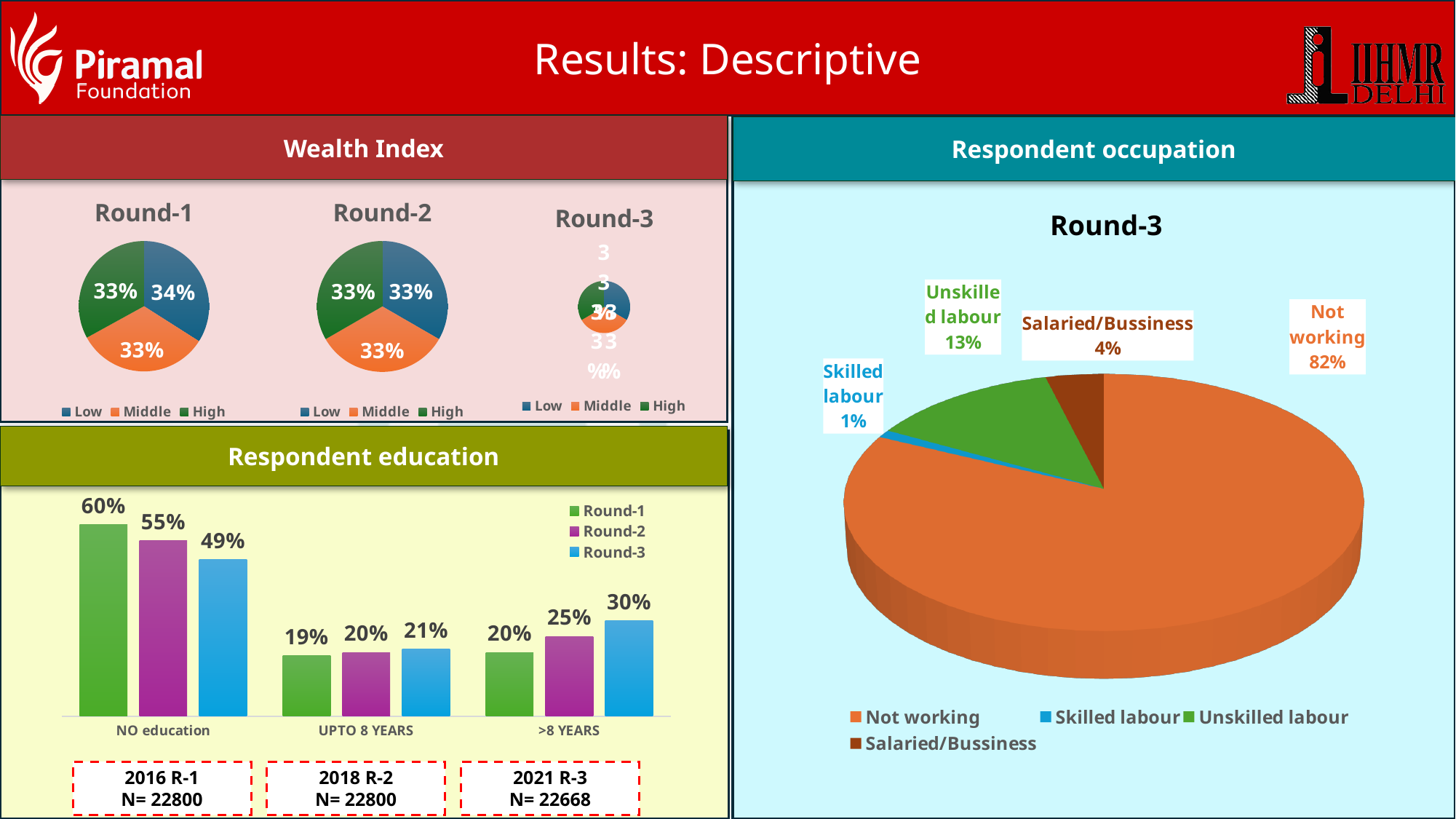
What kind of chart is the Respondent education chart? Bar chart How many series does the legend of the Wealth Index Round-1 pie chart list? 3 In the Respondent education chart, what is the difference between the Round-1 and Round-3 values for NO education? 11% In the Respondent education chart, which is larger for UPTO 8 YEARS: Round-2 or Round-3? Round-3 In the Wealth Index Round-1 pie chart, what percentage is labelled for the Low slice? 34% In the Wealth Index Round-1 pie chart, which category has the largest share? Low In the Respondent occupation Round-3 pie chart, which category has the smallest share? Skilled labour In the Respondent education chart, what is the Round-3 value for >8 YEARS? 30% In the Respondent education chart, how do the NO education values change from Round-1 to Round-3? They fall In the Respondent education chart, what is the Round-1 value for NO education? 60% In the Respondent occupation Round-3 pie chart, what share is labelled for Not working? 82% In the Wealth Index Round-2 pie chart, what percentage is shown for the Middle slice? 33%